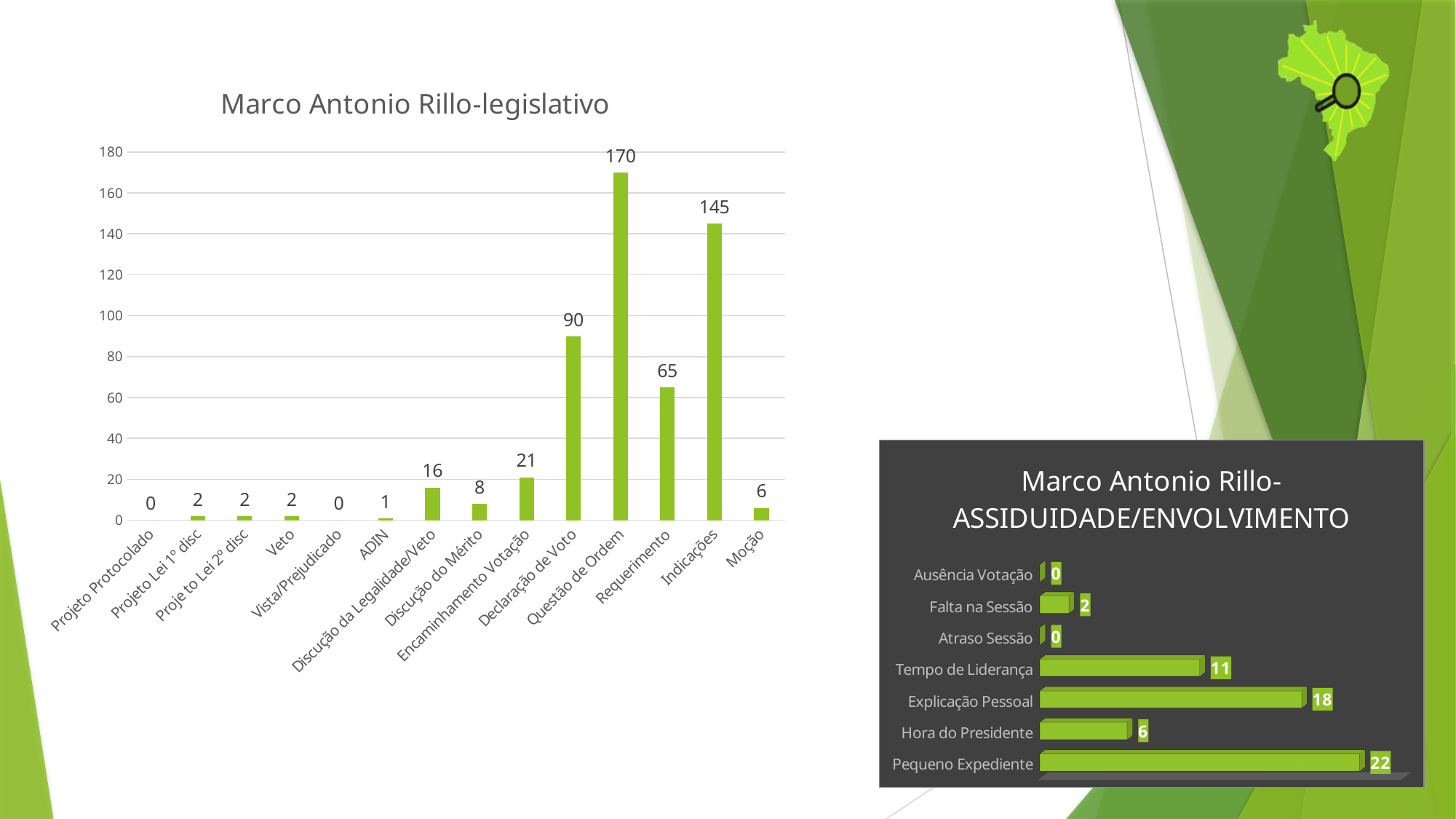
In the 'Marco Antonio Rillo-legislativo' chart, what is the value for Questão de Ordem? 170 In the 'Marco Antonio Rillo-ASSIDUIDADE/ENVOLVIMENTO' chart, how many categories are shown? 7 In the 'Marco Antonio Rillo-legislativo' chart, which category has the highest value? Questão de Ordem What kind of chart is 'Marco Antonio Rillo-legislativo'? Bar chart In the 'Marco Antonio Rillo-legislativo' chart, which is larger: Declaração de Voto or Requerimento? Declaração de Voto In the 'Marco Antonio Rillo-legislativo' chart, how many categories are shown on the x axis? 14 In the 'Marco Antonio Rillo-ASSIDUIDADE/ENVOLVIMENTO' chart, what is the difference between Explicação Pessoal and Tempo de Liderança? 7 In the 'Marco Antonio Rillo-legislativo' chart, what is the value for Indicações? 145 In the 'Marco Antonio Rillo-ASSIDUIDADE/ENVOLVIMENTO' chart, what is the value for Pequeno Expediente? 22 In the 'Marco Antonio Rillo-ASSIDUIDADE/ENVOLVIMENTO' chart, which category has the highest value? Pequeno Expediente In the 'Marco Antonio Rillo-legislativo' chart, what is the value for Encaminhamento Votação? 21 In the 'Marco Antonio Rillo-legislativo' chart, what is the difference between Questão de Ordem and Indicações? 25